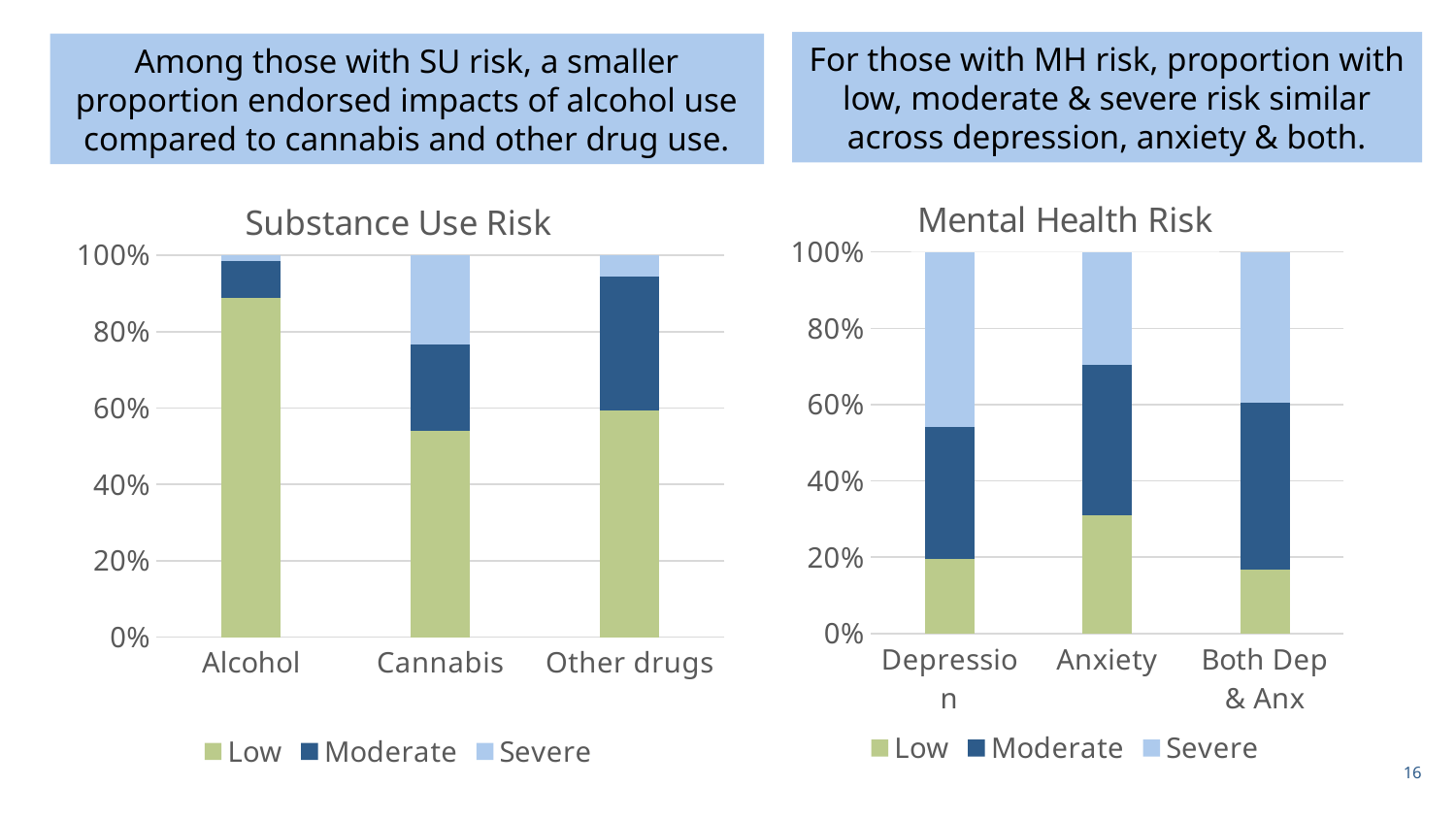
In the Mental Health Risk chart, what does each stacked bar total? 100% What are the legend entries of the Substance Use Risk chart? Low, Moderate, Severe What kind of chart is the Substance Use Risk chart? Stacked bar chart How many categories are shown on the x axis of the Substance Use Risk chart? 3 In the Substance Use Risk chart, which category has the smallest Severe share? Alcohol In the Mental Health Risk chart, is the Low share for Anxiety greater or less than 20%? greater In the Substance Use Risk chart, is the Low share for Alcohol greater or less than 80%? greater In the Substance Use Risk chart, which category has the largest Low share? Alcohol In the Mental Health Risk chart, which category has the largest Severe share? Depression How many series does the legend of the Mental Health Risk chart list? 3 In the Mental Health Risk chart, which category has the largest Low share? Anxiety In the Substance Use Risk chart, is the Low share for Cannabis greater or less than 60%? less